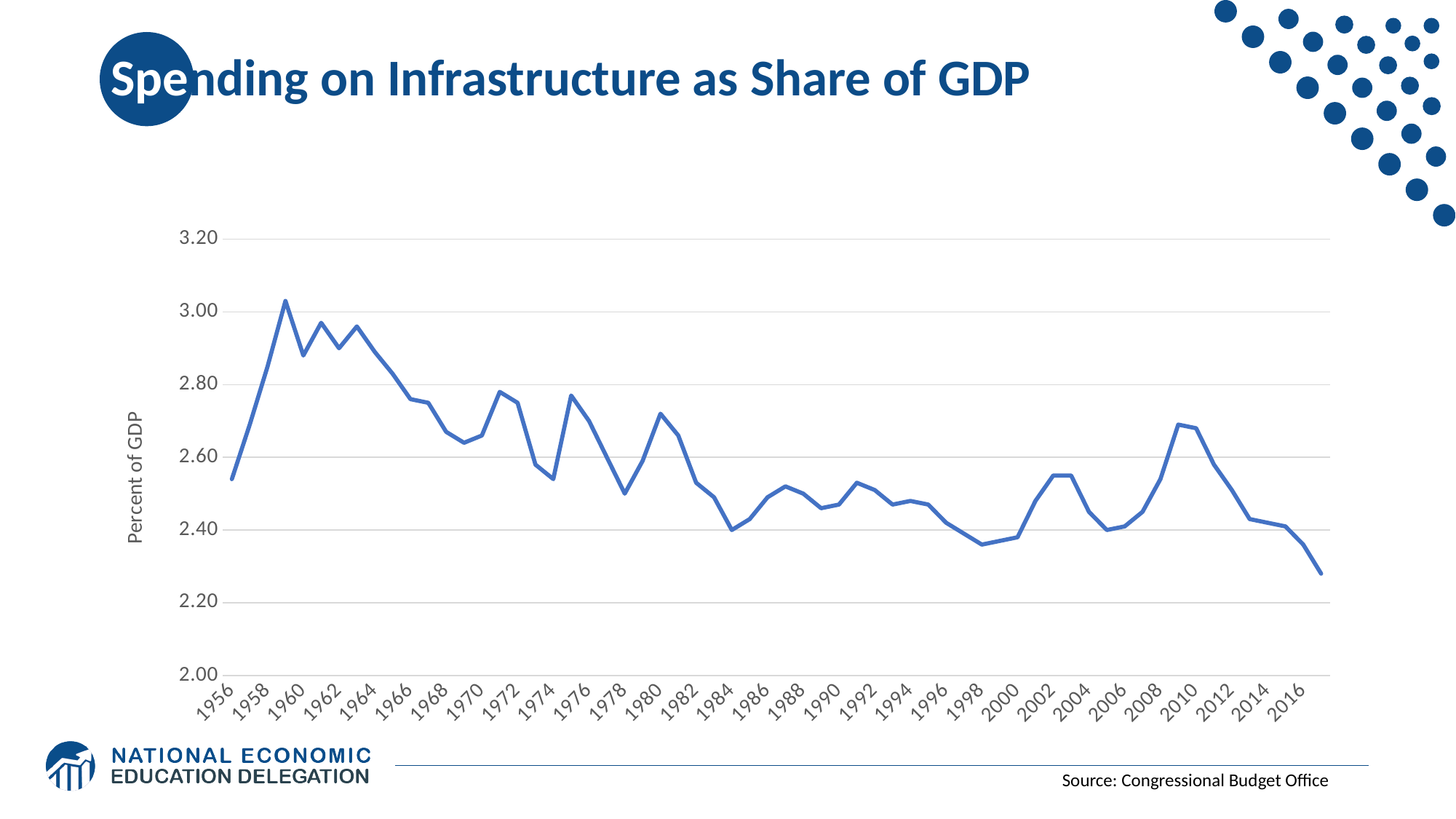
Does infrastructure spending as a share of GDP rise or fall between 2010 and 2017? fall Which year has the higher infrastructure spending as a share of GDP, 1964 or 1984? 1964 Is the value for 1972 greater or less than 2.60? greater What is the title of the chart? Spending on Infrastructure as Share of GDP In which year is infrastructure spending as a share of GDP at its lowest point? 2017 Is the value for 2010 greater or less than 2.60? greater Is the value for 2017 greater or less than 2.40? less What is the label on the vertical axis of the chart? Percent of GDP Which year has the higher infrastructure spending as a share of GDP, 2002 or 2010? 2010 What kind of chart is shown on the slide? line chart In which year does infrastructure spending as a share of GDP reach its highest point? 1959